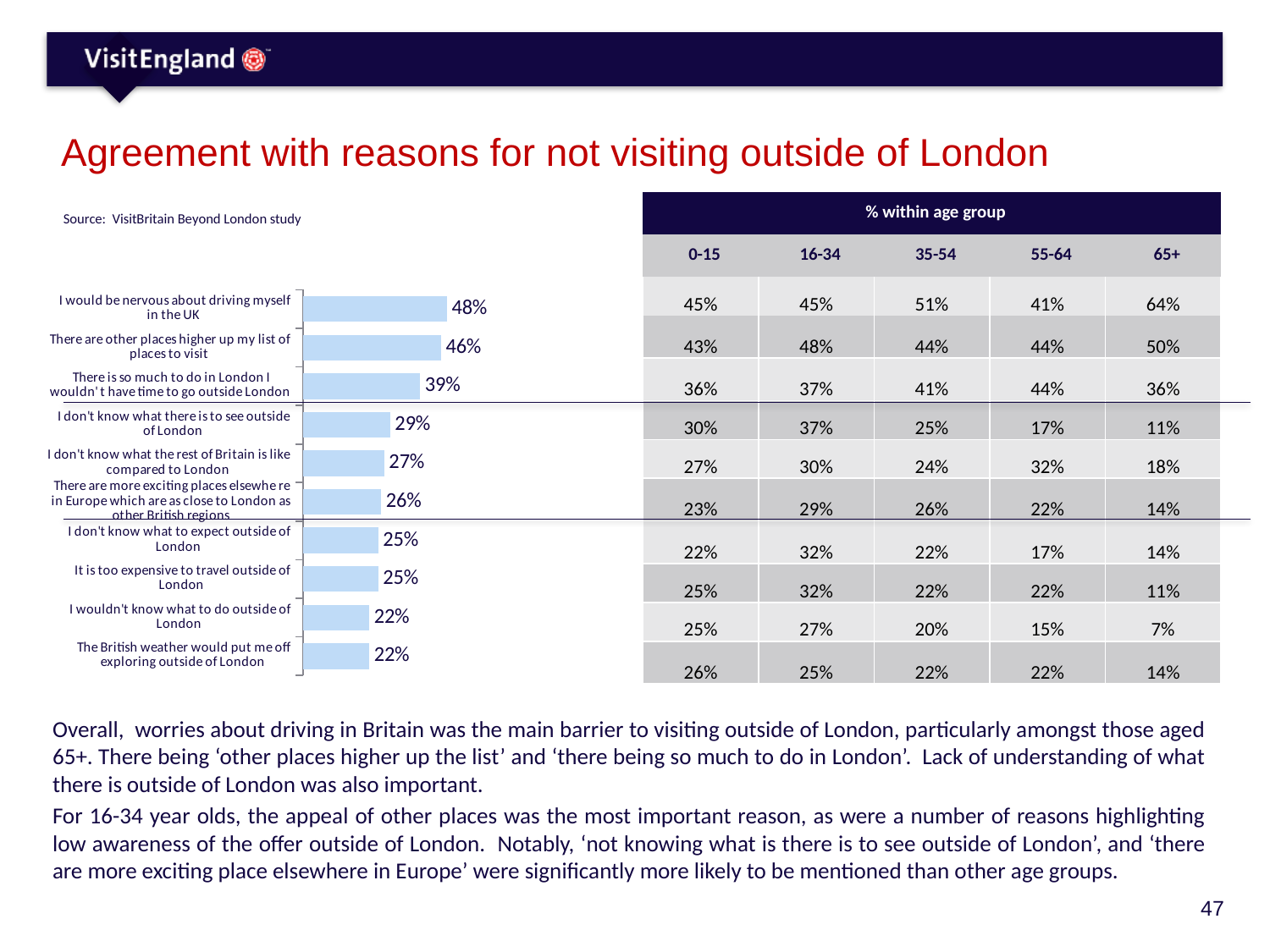
What is the value for 'It is too expensive to travel outside of London'? 25% What is the lowest value shown in the bar chart? 22% Do the bar values rise or fall going from the top category to the bottom category? fall What is the difference between 'I would be nervous about driving myself in the UK' and 'There is so much to do in London I wouldn't have time to go outside London'? 9% What is the value for 'I don't know what there is to see outside of London'? 29% What is the value for 'I would be nervous about driving myself in the UK'? 48% Which reason has the highest value in the bar chart? I would be nervous about driving myself in the UK What is the value for 'There are other places higher up my list of places to visit'? 46% How many reasons (categories) are plotted in the bar chart? 10 Which is larger: 'I don't know what the rest of Britain is like compared to London' or 'I wouldn't know what to do outside of London'? I don't know what the rest of Britain is like compared to London What is the title of the chart on the slide? Agreement with reasons for not visiting outside of London What kind of chart is shown on the slide? bar chart